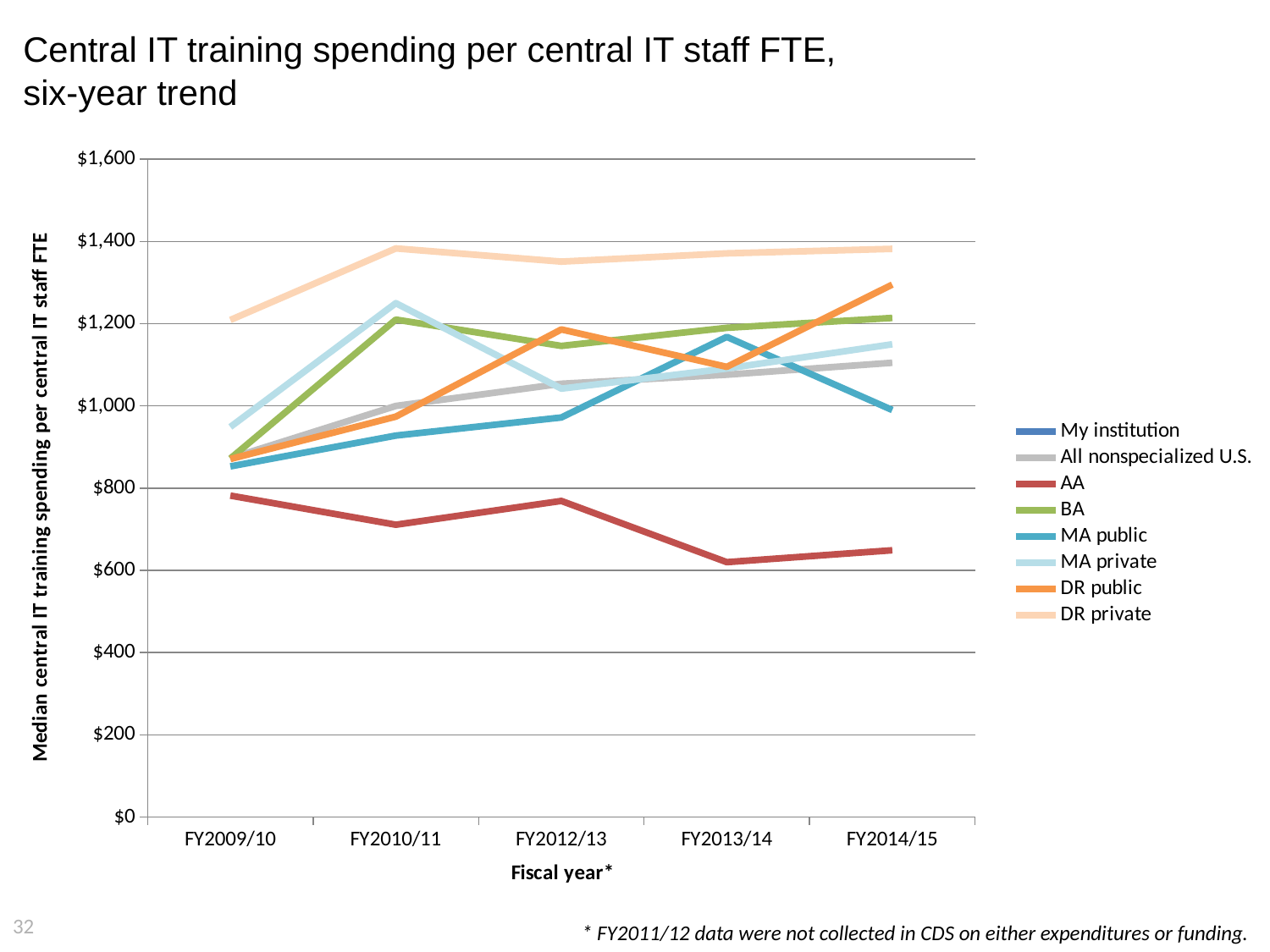
In which fiscal year does DR public reach its highest value? FY2014/15 What is the title of the x axis? Fiscal year* How many series does the legend list? 8 How many fiscal years are shown on the x axis? 5 Which series has the highest value in FY2014/15? DR private Is the value for DR private in FY2010/11 greater or less than $1,200? greater What kind of chart is shown on the slide? line chart Is the value for AA in FY2013/14 greater or less than $800? less In FY2014/15, which is larger: DR public or MA public? DR public Is the value for MA public in FY2009/10 greater or less than $1,000? less Which series has the lowest value in FY2014/15? AA Does the All nonspecialized U.S. line rise or fall from FY2009/10 to FY2014/15? rise